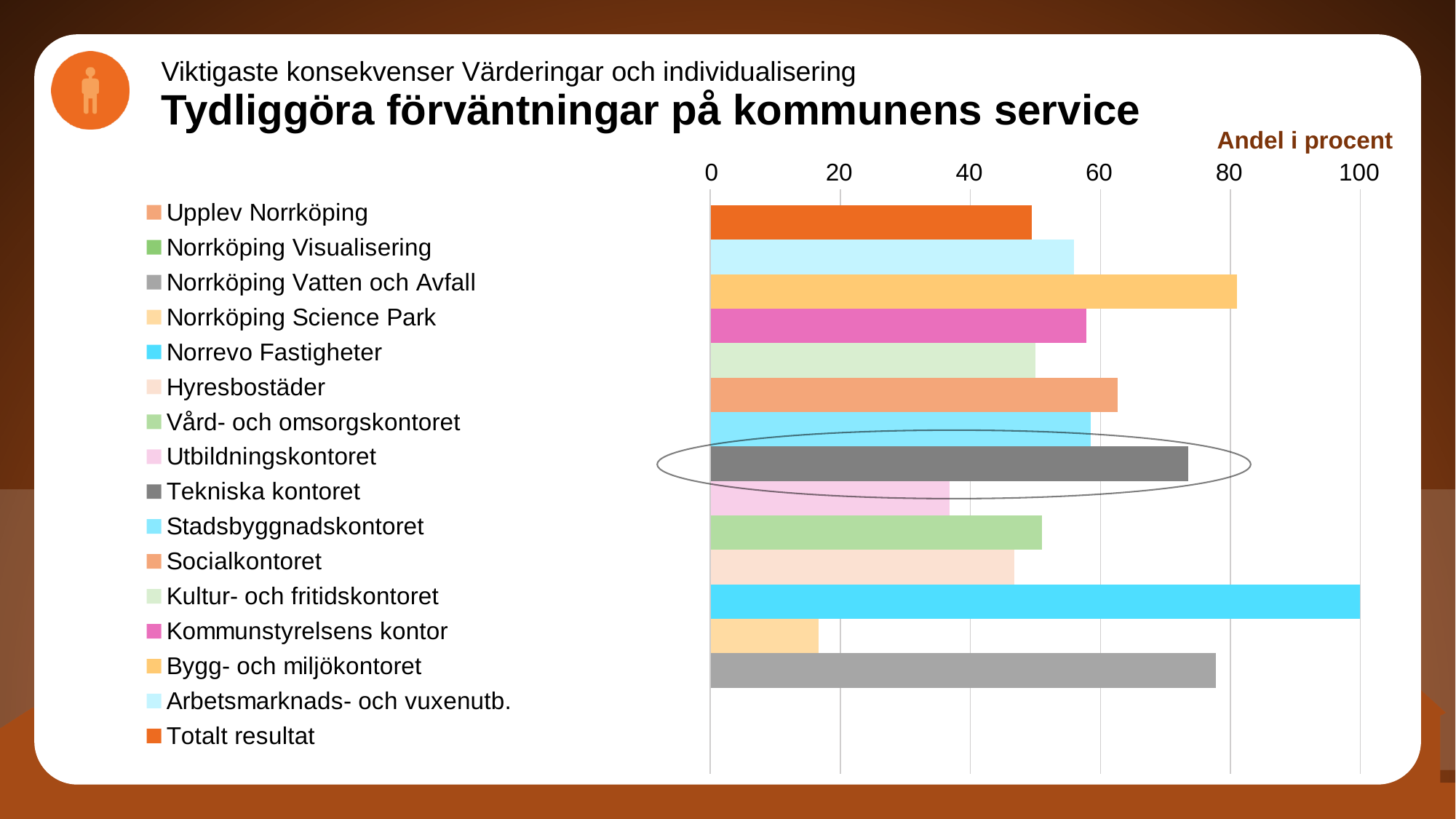
Is the value for Utbildningskontoret greater or less than 40? less What kind of chart is shown on the slide? bar chart How many entries does the legend list? 16 Is the value for Norrköping Science Park greater or less than 20? less Which series' bar is circled on the chart? Tekniska kontoret Which series has the longest bar? Norrevo Fastigheter Is the value for Tekniska kontoret greater or less than 60? greater What is the value for Norrevo Fastigheter? 100 Which is larger, the value for Norrköping Vatten och Avfall or the value for Socialkontoret? Norrköping Vatten och Avfall Which series has the shortest bar? Norrköping Science Park What label is shown above the horizontal axis of the chart? Andel i procent